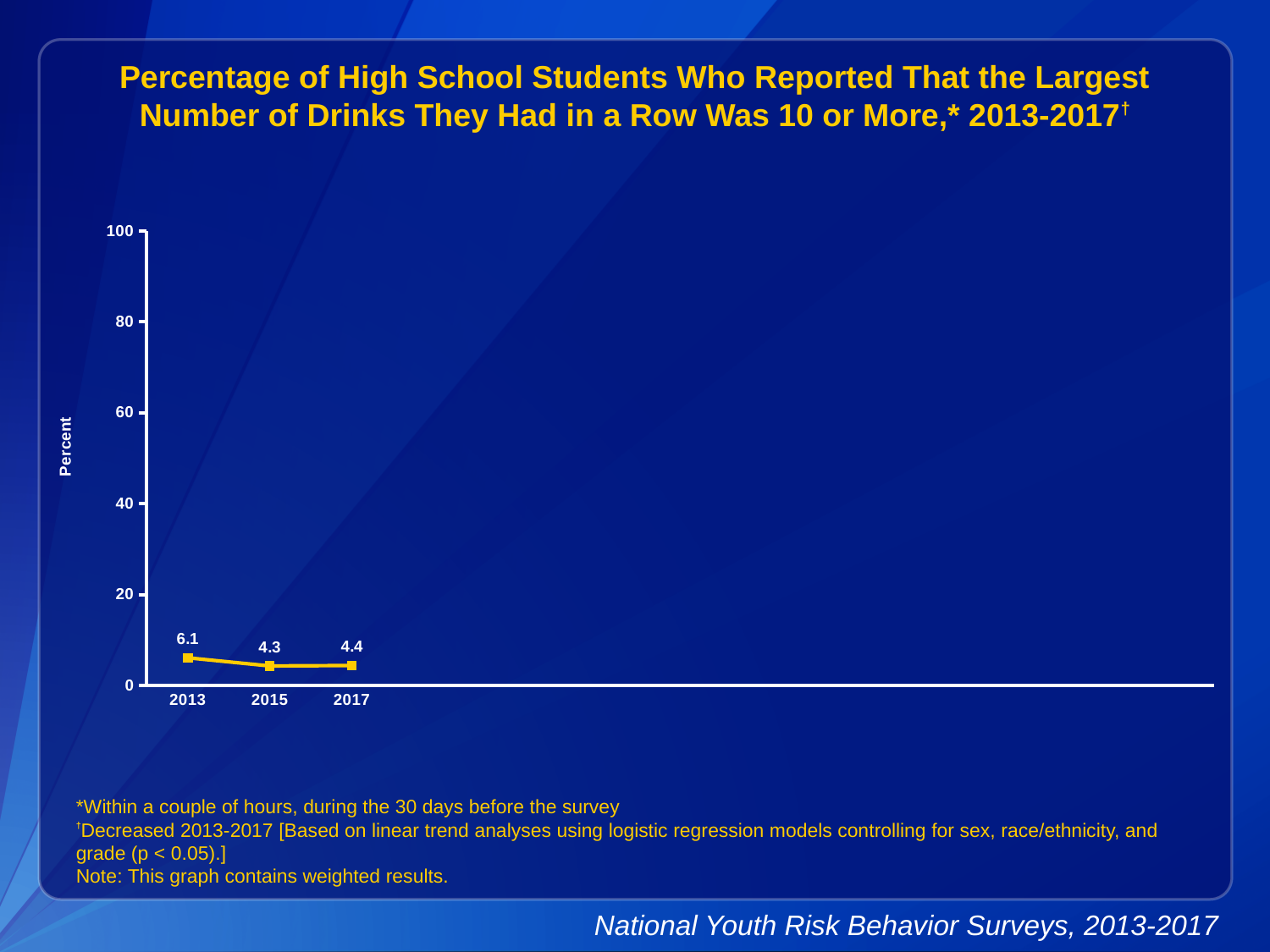
What kind of chart is shown on the slide? line chart Is the value for 2013 greater or less than 20? less How many years are plotted on the chart? 3 What is the difference between the 2013 and 2017 values? 1.7 Which year had the highest percentage? 2013 What was the percentage in 2015? 4.3 What was the percentage of high school students who reported having 10 or more drinks in a row in 2013? 6.1 What is the difference between the 2013 and 2015 values? 1.8 What is the label on the y axis? Percent Which year had a larger value, 2013 or 2017? 2013 What was the percentage in 2017? 4.4 Which year had the lowest percentage? 2015